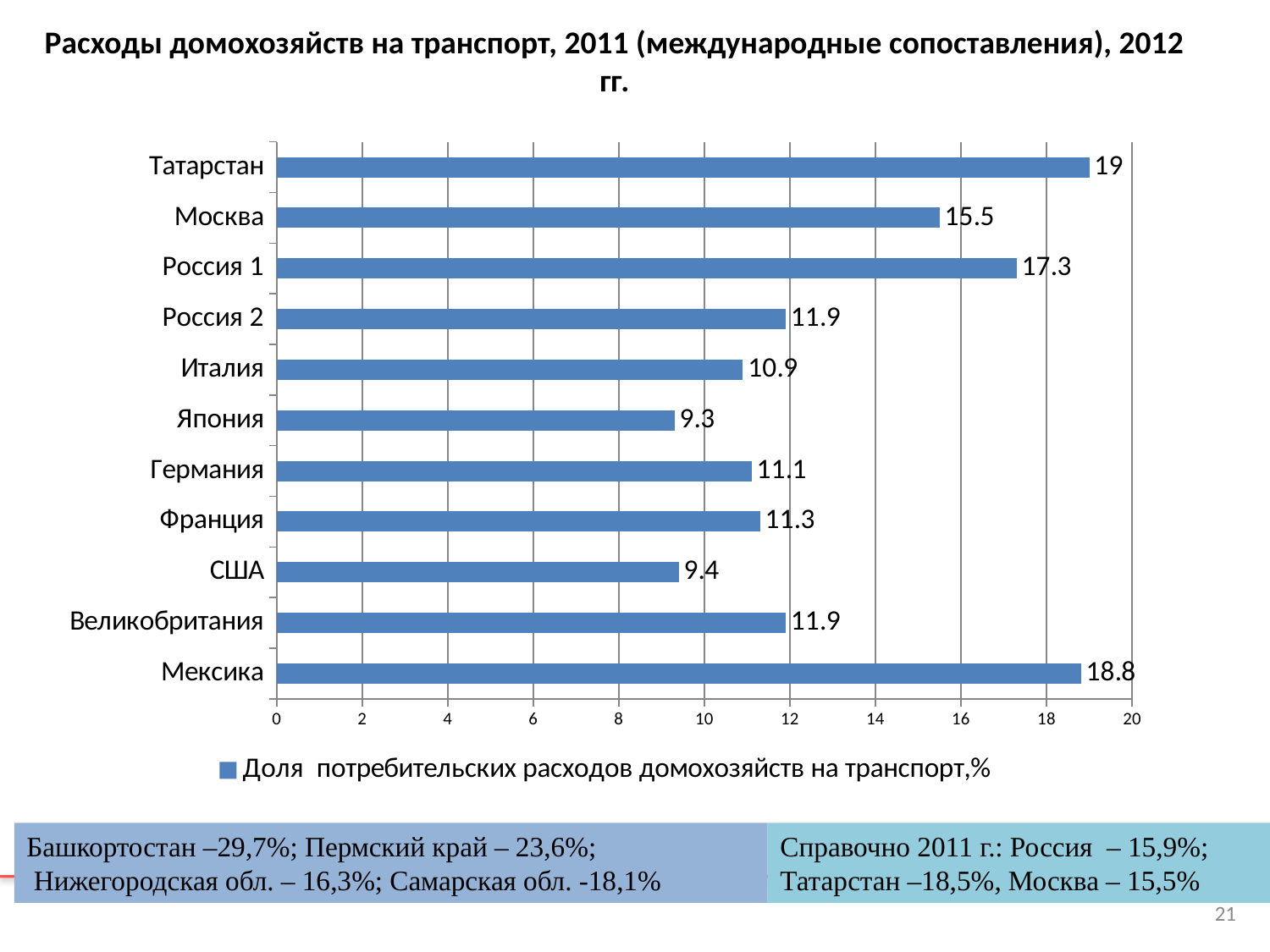
What is the value for Япония? 9.3 How many categories are shown in the chart? 11 What is the value for Мексика? 18.8 What kind of chart is shown on the slide? bar chart What is the difference between the values for Татарстан and Москва? 3.5 Which is larger, the value for Франция or the value for Германия? Франция Is the value for Италия greater or less than 10? greater How many series does the legend list? 1 Which category has the lowest value? Япония What is the value for Татарстан? 19 Which category has the highest value? Татарстан What is the value for Россия 1? 17.3